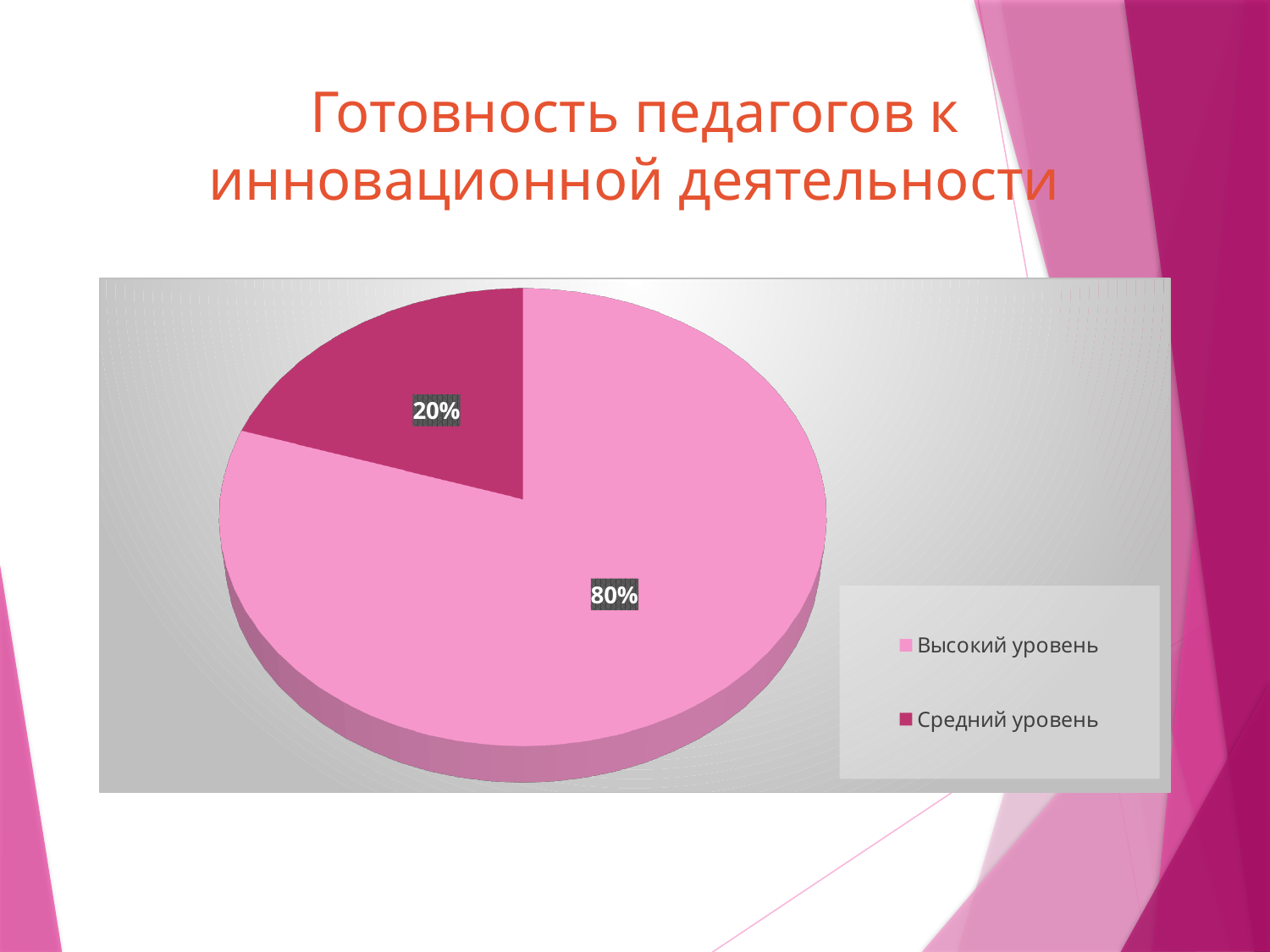
What is the title of the slide containing the chart? Готовность педагогов к инновационной деятельности Which legend entry is shown in the darker magenta colour? Средний уровень Which category has the largest slice of the pie? Высокий уровень How many slices does the pie chart have? 2 What is the difference between the shares of "Высокий уровень" and "Средний уровень"? 60% What kind of chart is shown on the slide? pie chart Which is larger: the slice for "Высокий уровень" or the slice for "Средний уровень"? Высокий уровень What share of the pie does "Высокий уровень" have? 80% Which category has the smallest slice of the pie? Средний уровень How many entries does the legend list? 2 What share of the pie does "Средний уровень" have? 20%